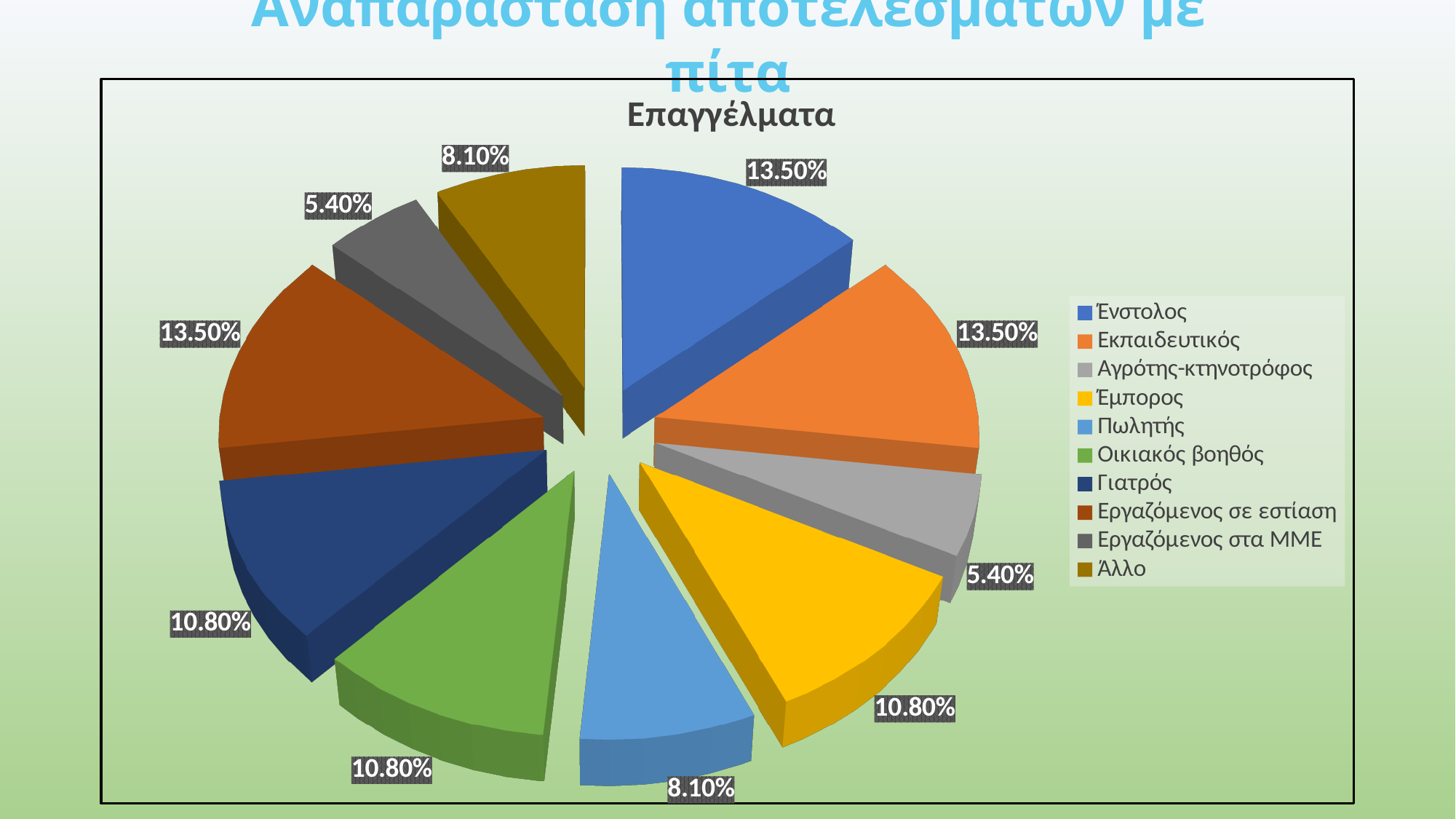
What kind of chart is shown on the slide? pie chart What is the difference between the share for Εκπαιδευτικός and the share for Οικιακός βοηθός? 2.70% What share of the pie does Έμπορος have? 10.80% What colour is the slice for Έμπορος? yellow What is the title of the chart? Επαγγέλματα What share of the pie does Αγρότης-κτηνοτρόφος have? 5.40% Which is larger, the share for Γιατρός or the share for Εργαζόμενος στα ΜΜΕ? Γιατρός What share of the pie does Εργαζόμενος σε εστίαση have? 13.50% How many categories does the legend list? 10